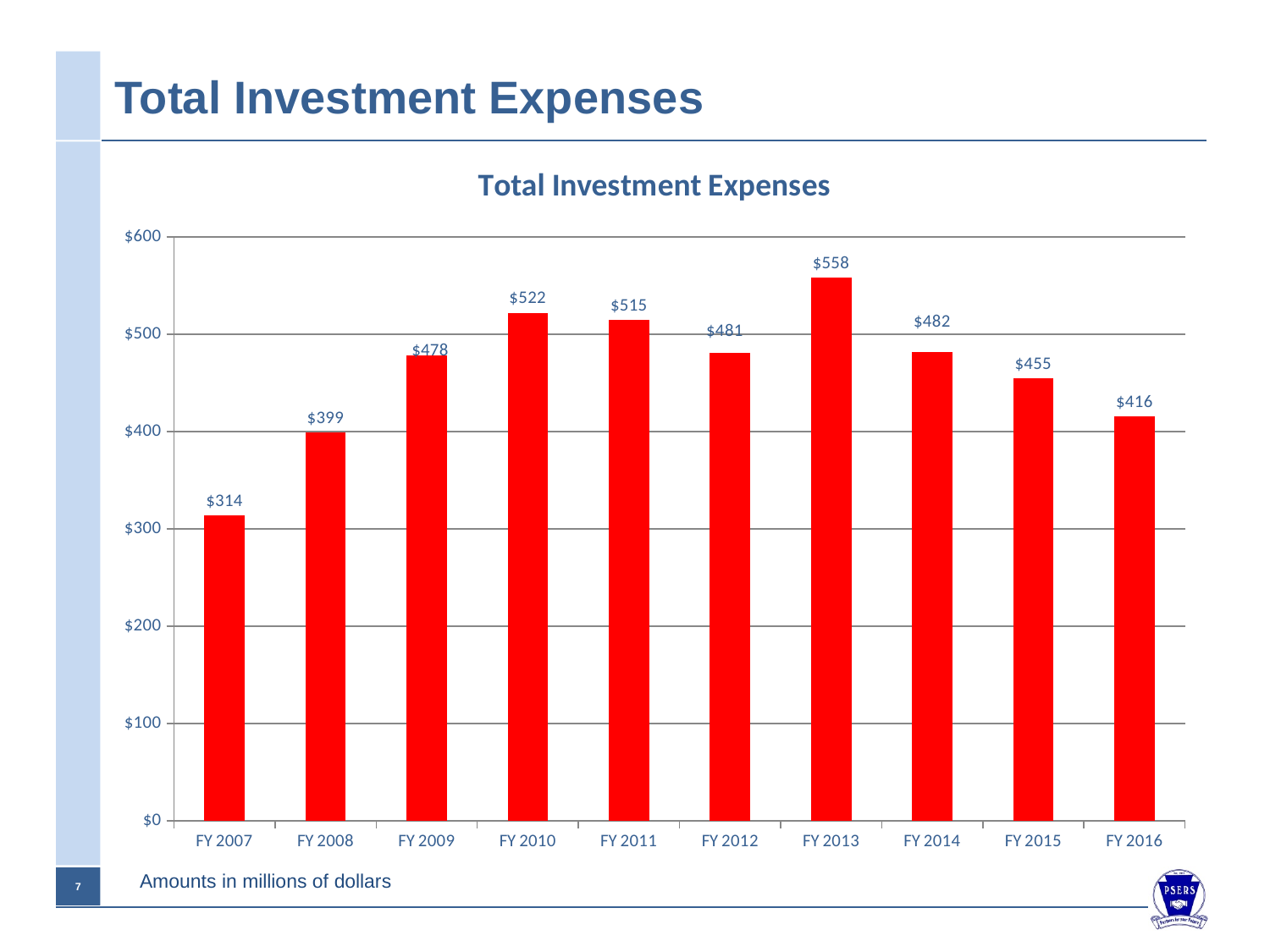
Which fiscal year has the lowest total investment expenses? FY 2007 Do the values rise or fall from FY 2013 to FY 2016? fall Which is larger, the value for FY 2011 or the value for FY 2015? FY 2011 What is the value for FY 2007? $314 Which fiscal year has the highest total investment expenses? FY 2013 How many fiscal years are shown on the x axis? 10 What is the value for FY 2010? $522 What is the difference between the values for FY 2013 and FY 2016? $142 What is the value for FY 2016? $416 Is the value for FY 2009 greater or less than $500? less What kind of chart is shown on the slide? bar chart What is the difference between the values for FY 2008 and FY 2007? $85